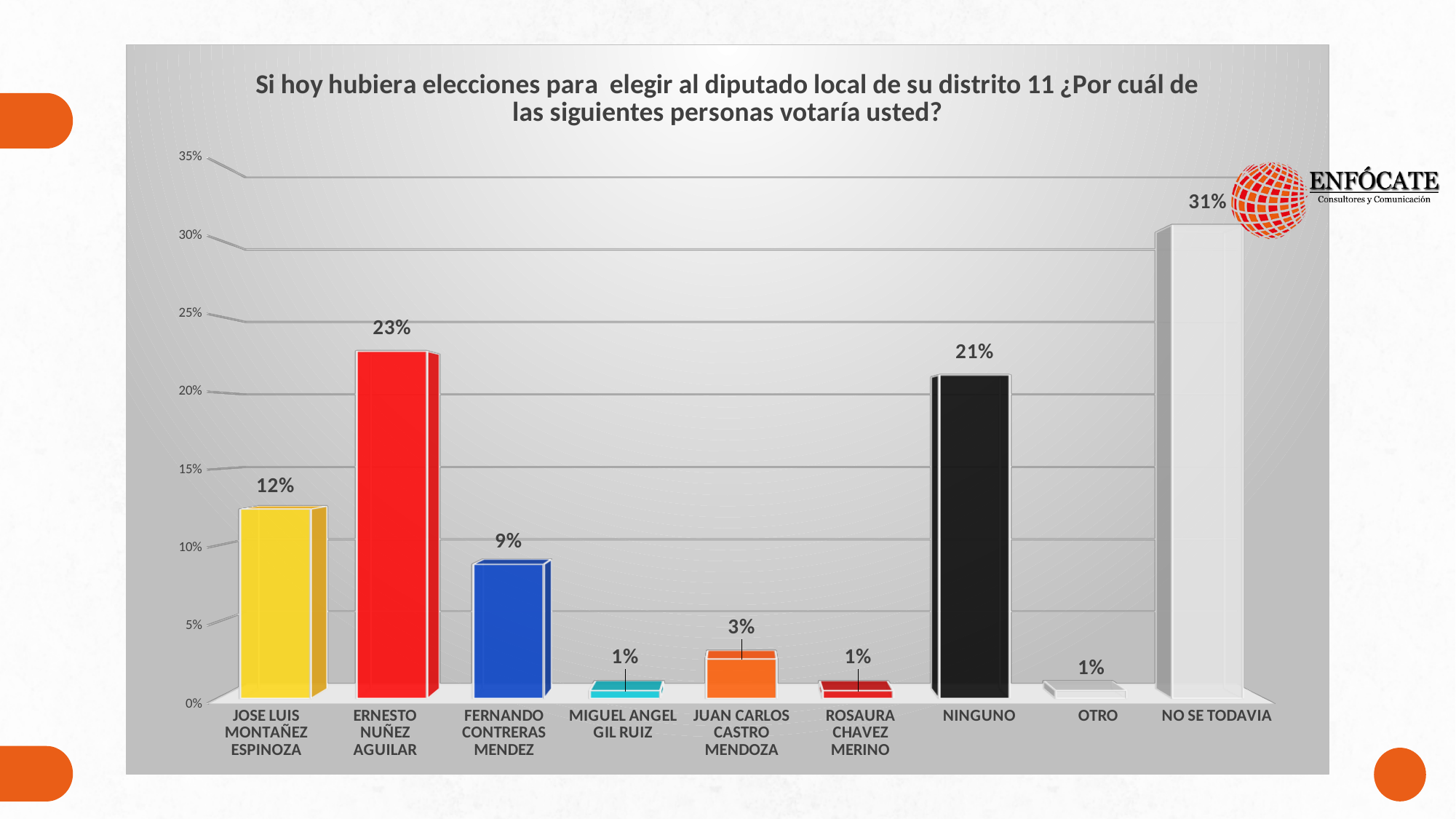
Which category has the highest value in the chart? No se todavia How many categories are shown on the x axis of the chart? 9 What is the difference between the values for No se todavia and Ernesto Nuñez Aguilar? 8 percentage points Which is larger, the value for Ninguno or the value for Jose Luis Montañez Espinoza? Ninguno What colour is the bar for Ernesto Nuñez Aguilar? Red What percentage of respondents said they would vote for Ernesto Nuñez Aguilar? 23% What percentage is shown for Fernando Contreras Mendez? 9% What is the value shown for Juan Carlos Castro Mendoza? 3% Which candidate has the highest percentage among the named candidates? Ernesto Nuñez Aguilar What kind of chart is shown on the slide? Bar chart What is the value shown for Ninguno? 21% What is the difference between the values for Jose Luis Montañez Espinoza and Fernando Contreras Mendez? 3 percentage points